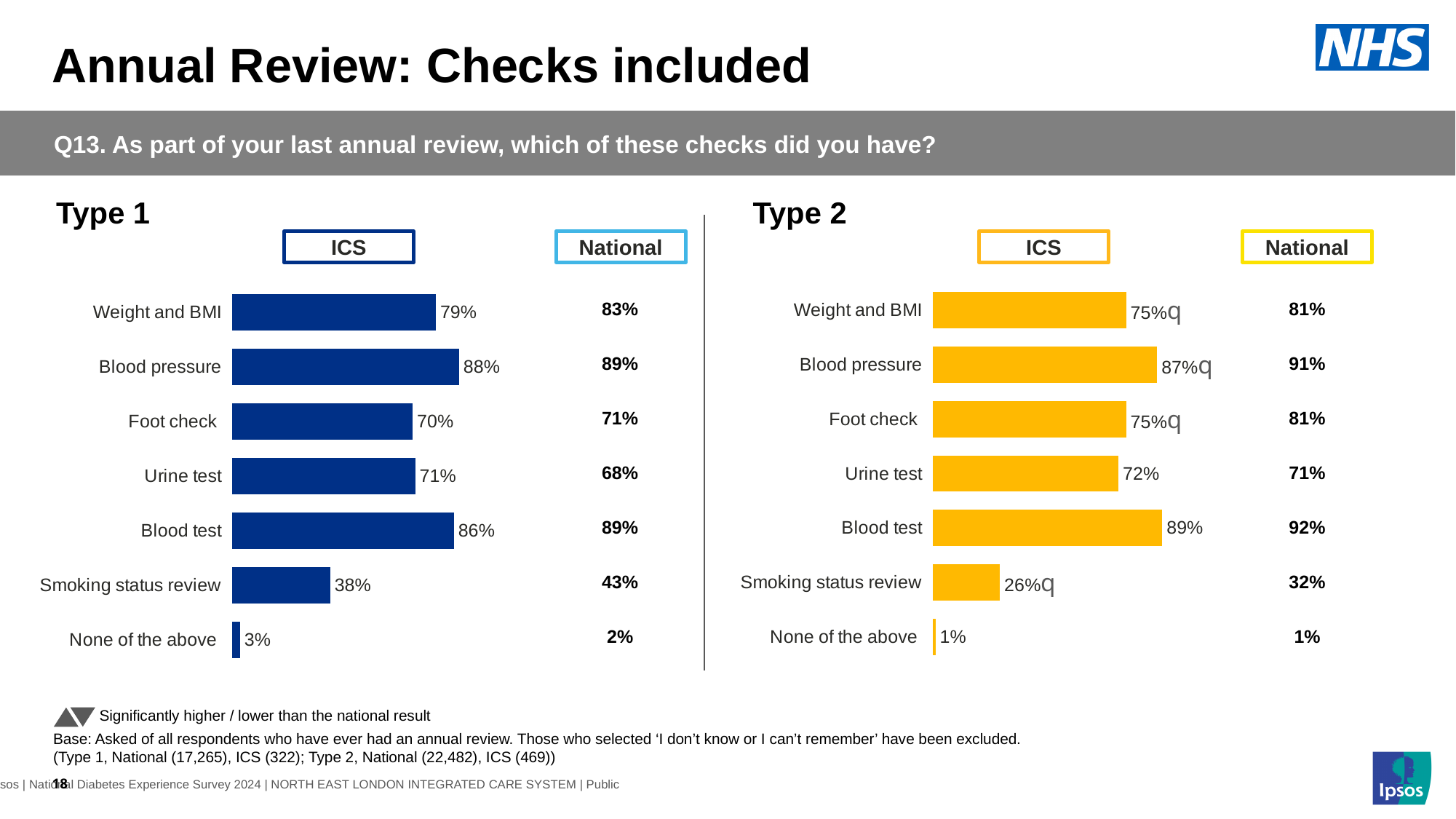
In the Type 1 chart, what is the National value for Urine test? 68% In the Type 2 chart, which check has the highest ICS value? Blood test In the Type 1 chart, which category has the lowest ICS value? None of the above In the Type 2 chart, is the ICS value for Weight and BMI higher or lower than the National value? lower What type of chart is used for the Type 2 ICS results? bar chart In the Type 1 chart, which is larger: the ICS value for Weight and BMI or the ICS value for Foot check? Weight and BMI How many checks (categories) are listed in the Type 1 chart? 7 In the Type 1 chart, what is the ICS value for Blood pressure? 88% What colour are the ICS bars in the Type 2 chart? yellow In the Type 2 chart, what is the difference between the ICS values for Blood test and Urine test? 17 percentage points In the Type 1 chart, what is the difference between the ICS and National values for Smoking status review? 5 percentage points In the Type 2 chart, what is the ICS value for Smoking status review? 26%